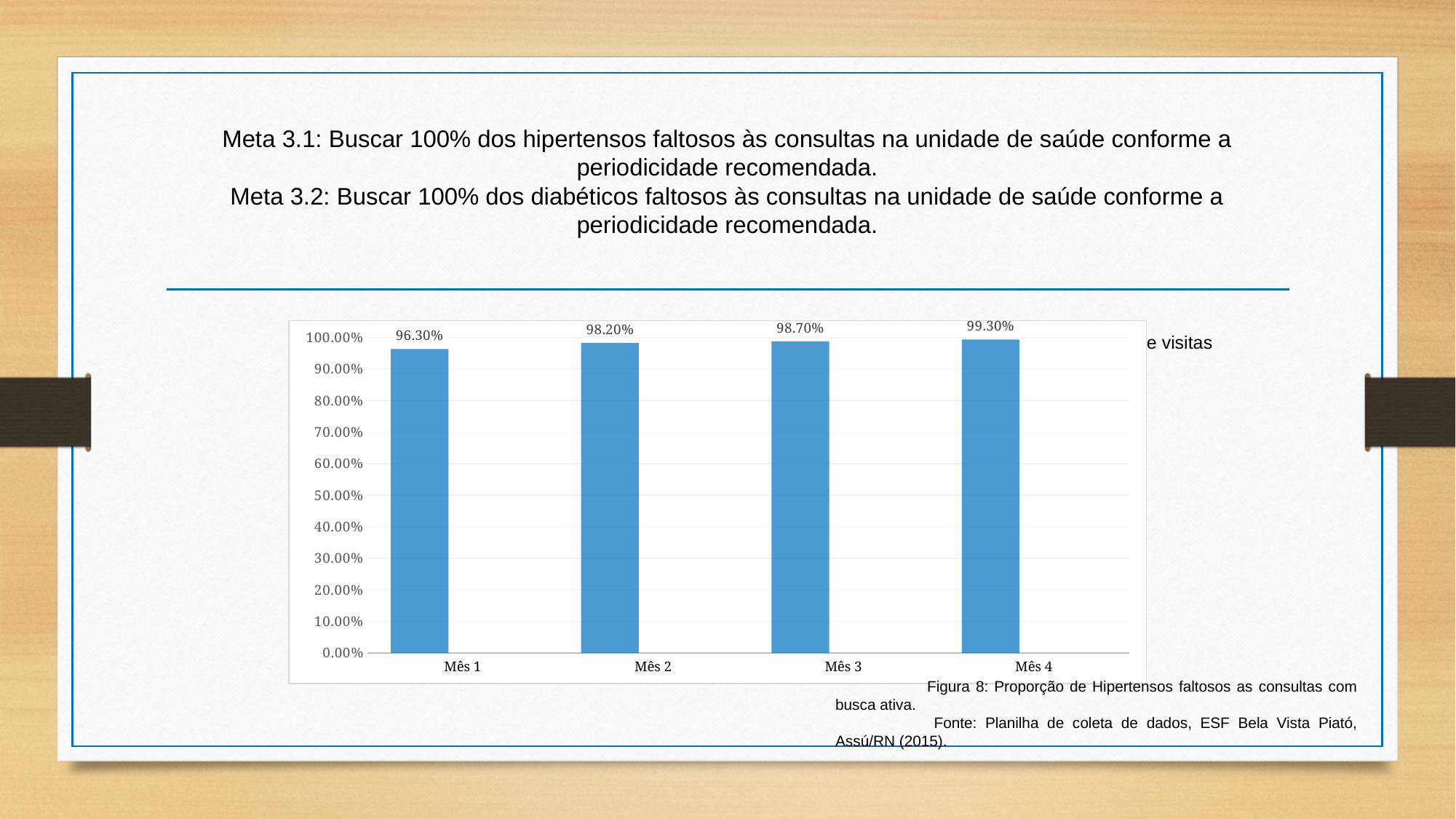
Do the values rise or fall from Mês 1 to Mês 4? Rise How many months are shown on the x axis? 4 What is the difference between the values for Mês 4 and Mês 1? 3.00% Which month has the lowest value? Mês 1 Which is larger, the value for Mês 2 or the value for Mês 3? Mês 3 What kind of chart is shown on the slide? Bar chart What is the value for Mês 4? 99.30% What is the value for Mês 2? 98.20% Which month has the highest value? Mês 4 What is the value for Mês 3? 98.70% What is the difference between the values for Mês 2 and Mês 1? 1.90% What is the value for Mês 1? 96.30%